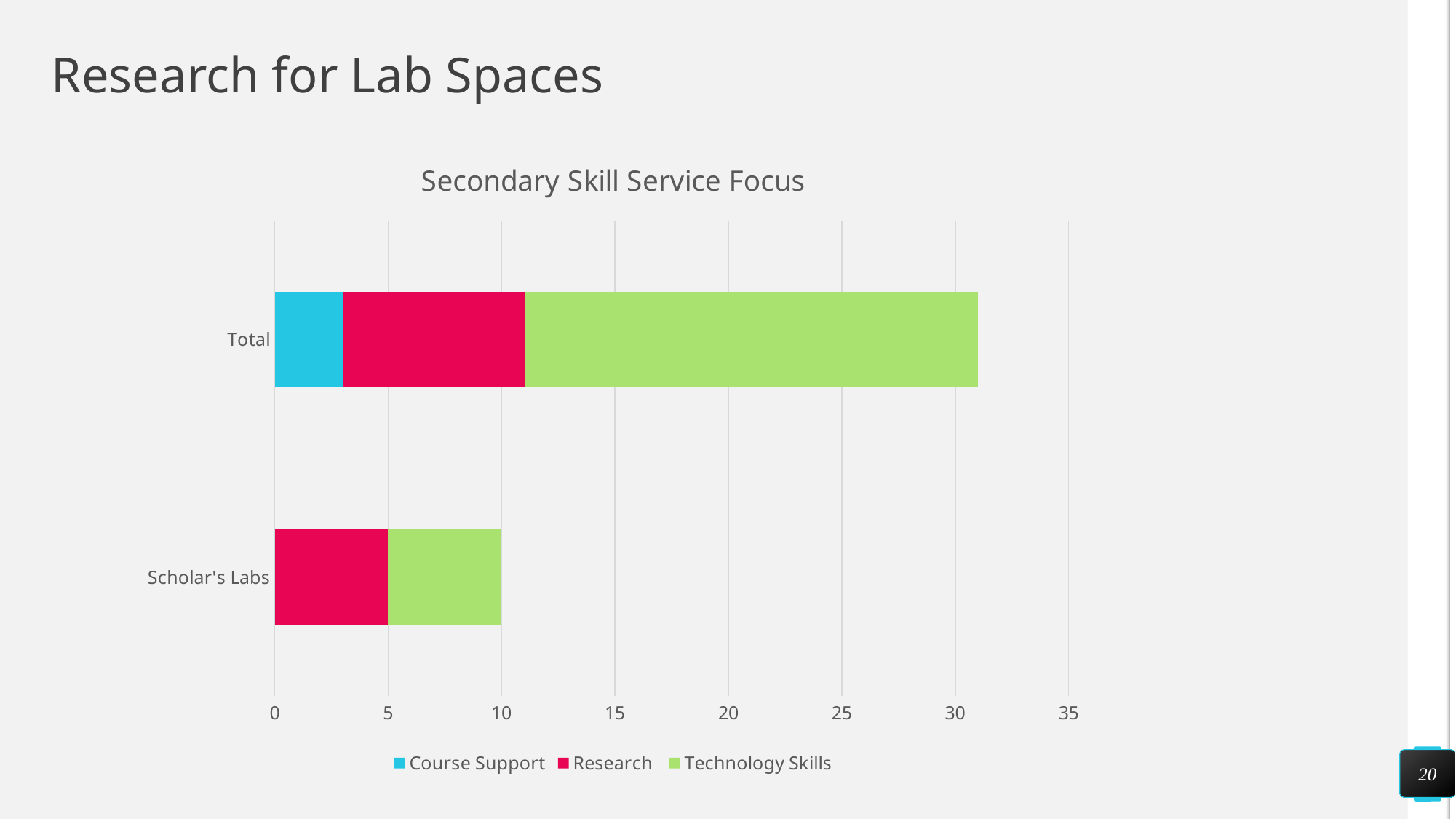
Which is larger, the stacked bar for Total or the stacked bar for Scholar's Labs? Total Is the Course Support value for Total greater or less than 5? less Which category has the shortest stacked bar? Scholar's Labs Is the total of the stacked bar for Total greater or less than 30? greater Which category has the longest stacked bar? Total How many categories are shown on the vertical axis? 2 How many series does the legend list? 3 What is the Research value for Scholar's Labs? 5 What is the total of the stacked bar for Scholar's Labs? 10 What kind of chart is shown on the slide? Bar chart Which series is shown in green in the legend? Technology Skills What is the title of the chart? Secondary Skill Service Focus